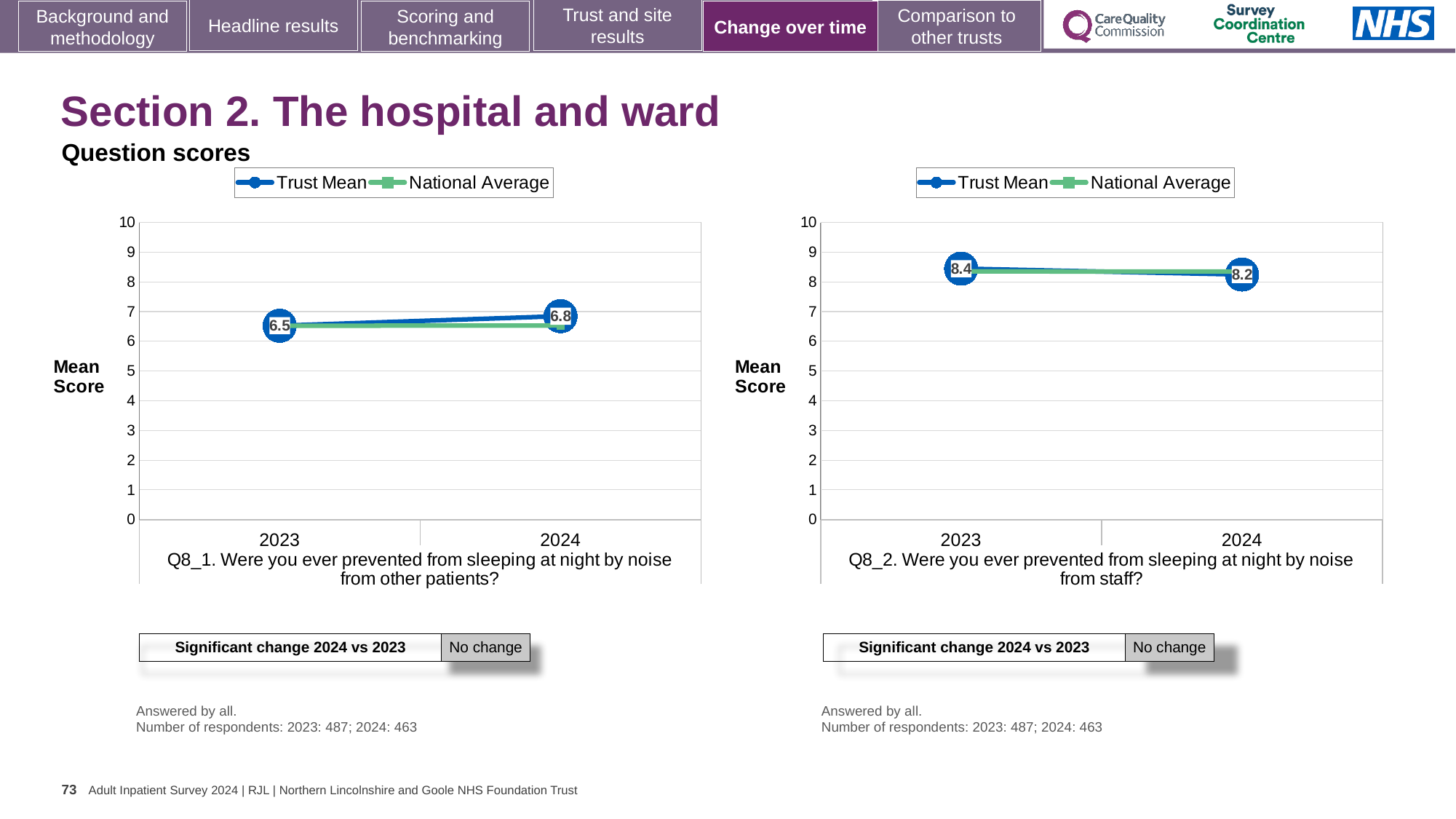
In the right chart (Q8_2), does the Trust Mean rise or fall from 2023 to 2024? fall What type of chart is used for Q8_2 on the right? line chart In the left chart (Q8_1, noise from other patients), what is the Trust Mean score for 2024? 6.8 In the left chart (Q8_1), by how much did the Trust Mean change from 2023 to 2024? 0.3 In the right chart (Q8_2), which year has the higher Trust Mean, 2023 or 2024? 2023 In the left chart (Q8_1, noise from other patients), what is the Trust Mean score for 2023? 6.5 In the left chart (Q8_1), does the Trust Mean rise or fall from 2023 to 2024? rise In the right chart (Q8_2, noise from staff), what is the Trust Mean score for 2024? 8.2 In the right chart (Q8_2, noise from staff), what is the Trust Mean score for 2023? 8.4 In the left chart (Q8_1), is the National Average for 2024 greater or less than 7? less In the right chart (Q8_2), what is the difference between the Trust Mean for 2023 and 2024? 0.2 How many series does the legend of the left chart list? 2